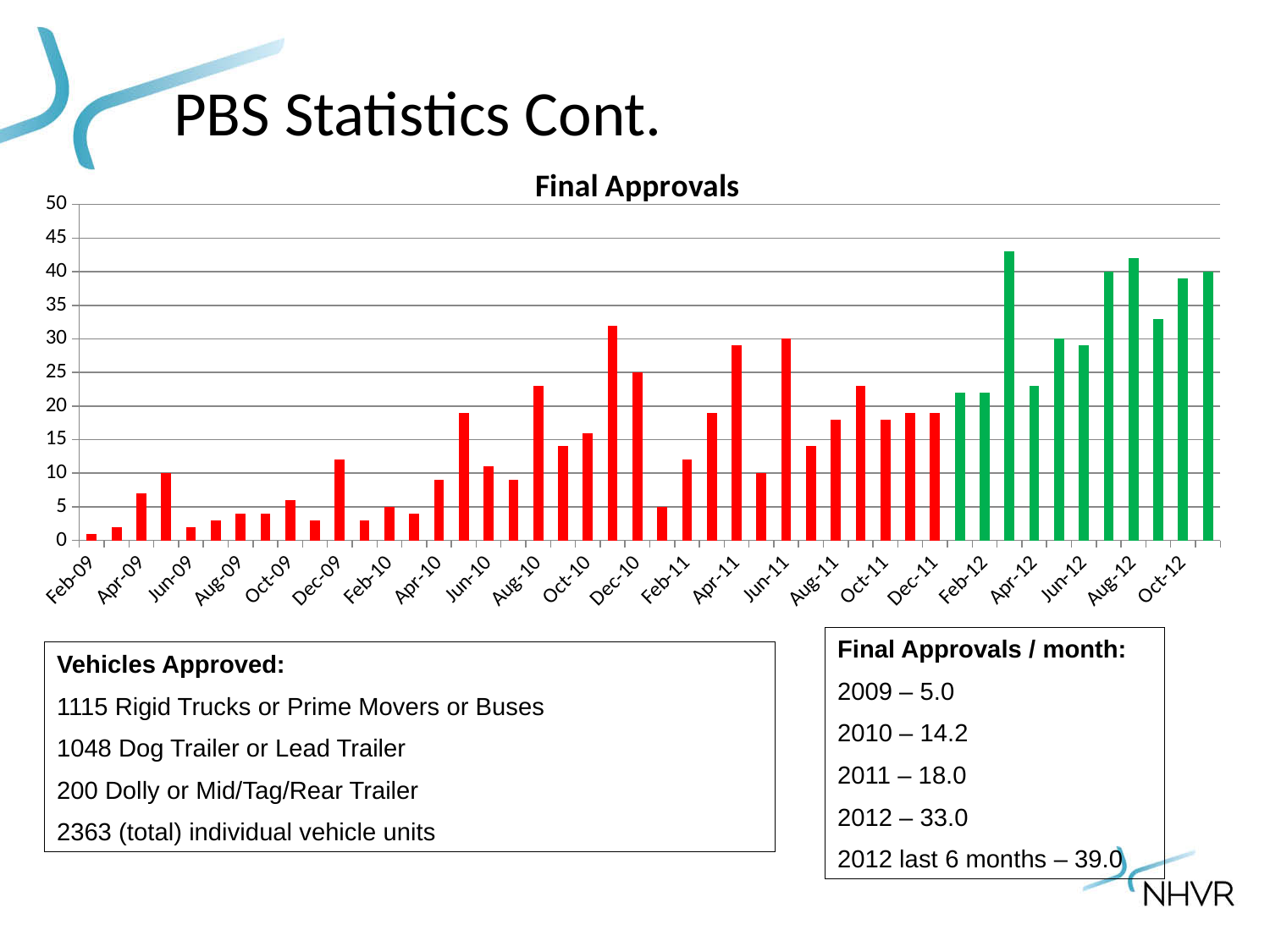
What two colours are used for the bars in the chart? red and green What is the title of the chart? Final Approvals Is the value for Aug-10 greater or less than 20? greater Do the final approvals generally rise or fall from Feb-09 to Oct-12? rise What kind of chart is shown on the slide? bar chart Is the value for Apr-12 greater or less than 40? less Is the value for Feb-09 greater or less than 5? less Which month has the lowest number of final approvals? Feb-09 Which is larger, the value for Dec-10 or the value for Feb-11? Dec-10